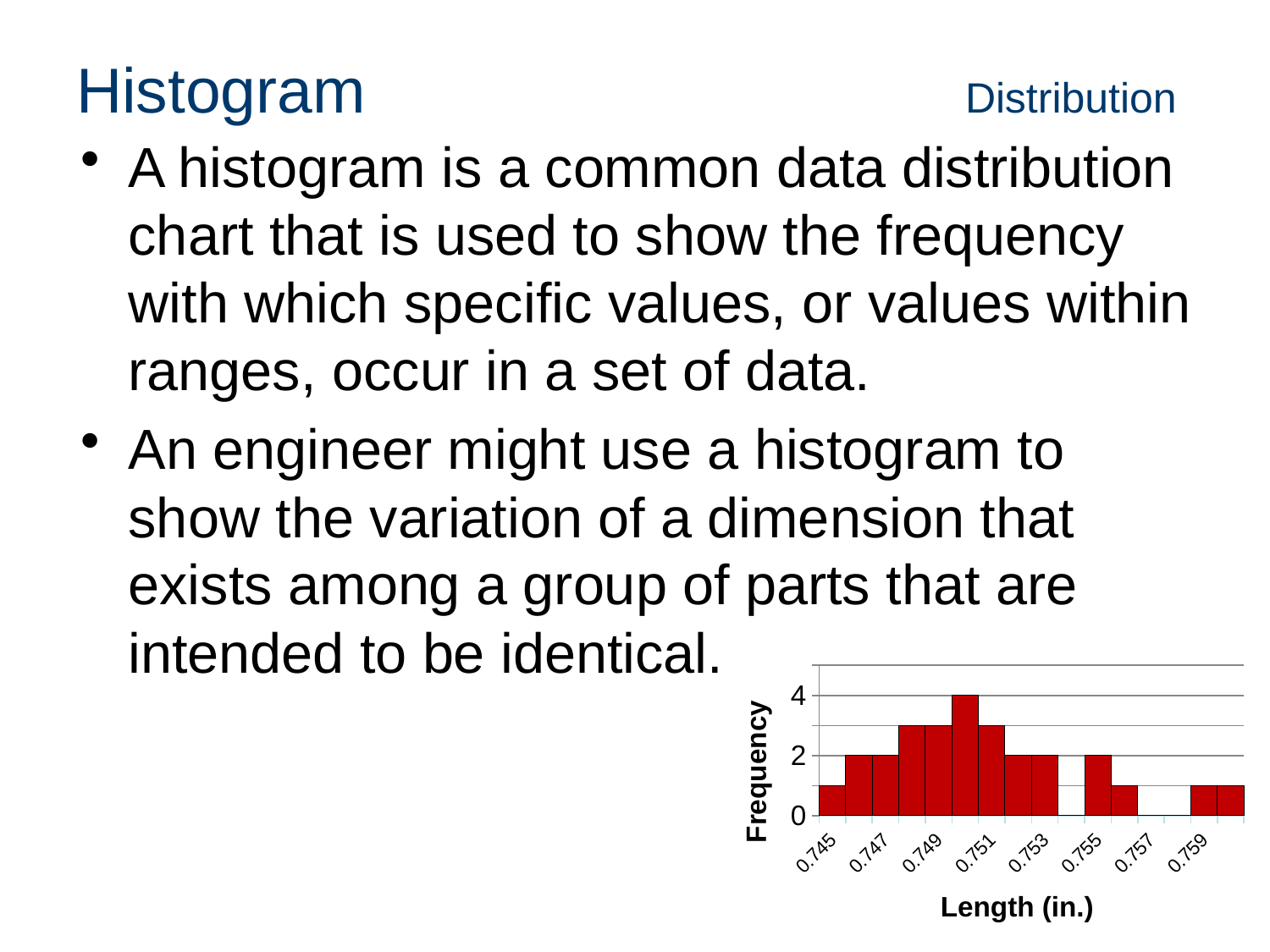
What is the frequency for a length of 0.747 in.? 2 Is the frequency for a length of 0.749 in. greater or less than 2? greater Is the frequency for a length of 0.745 in. greater or less than 2? less Which has the higher frequency, a length of 0.749 in. or 0.753 in.? 0.749 What is the frequency for a length of 0.757 in.? 0 What is the difference between the frequency at 0.747 in. and the frequency at 0.757 in.? 2 What type of chart is shown on the slide? bar chart What is the title of the horizontal axis of the histogram? Length (in.) What is the highest frequency reached by any bar in the histogram? 4 What is the frequency for a length of 0.753 in.? 2 What is the frequency for a length of 0.755 in.? 2